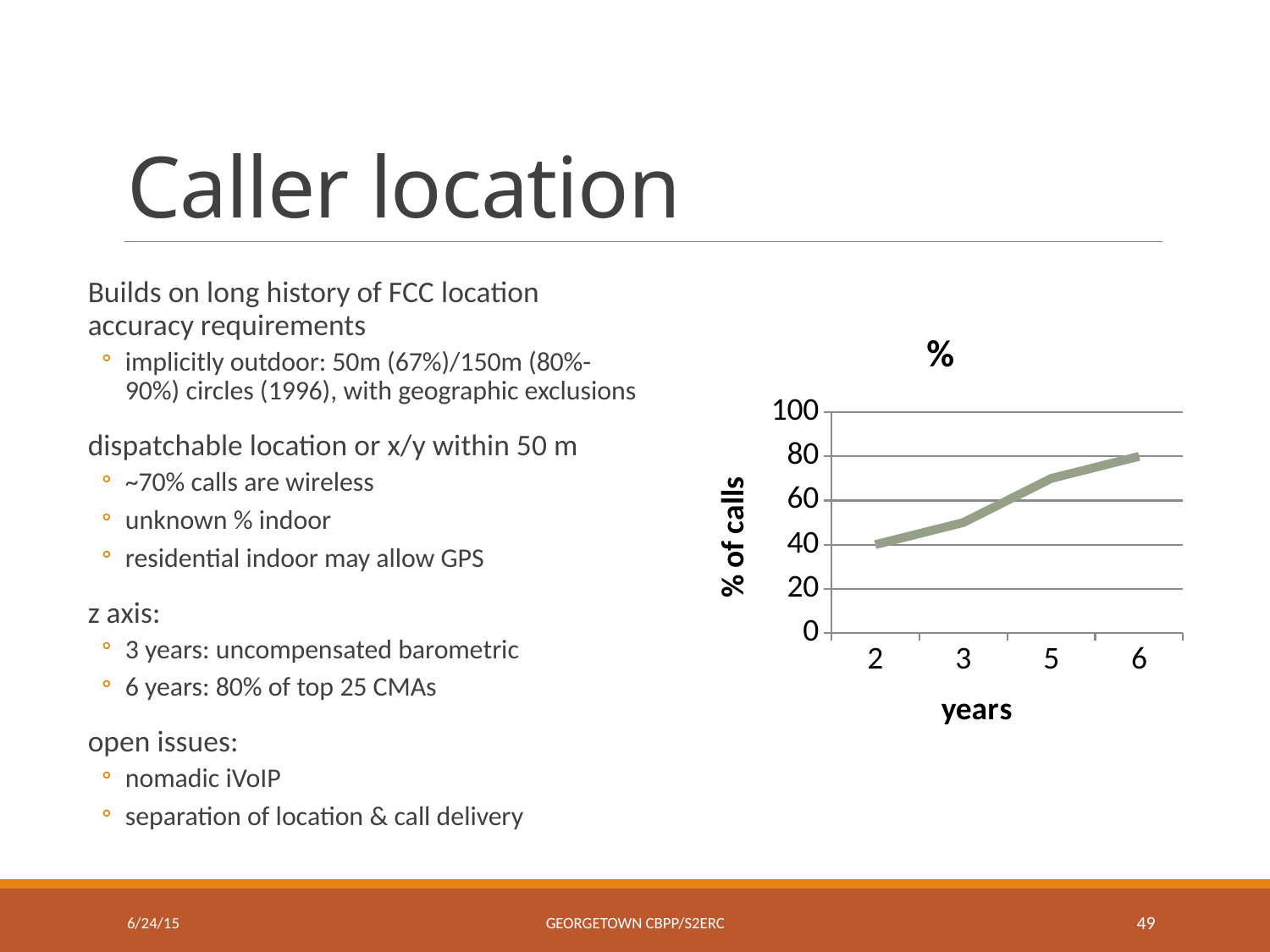
Which year has the highest % of calls? 6 What is the % of calls at year 2? 40 What is the title of the chart? % How many data points are plotted on the line? 4 Which is larger, the value for year 3 or the value for year 5? year 5 Is the value for year 5 greater or less than 60? greater What is the label of the x axis of the chart? years What is the % of calls at year 6? 80 Is the value for year 3 greater or less than 60? less What kind of chart is shown on the slide? line chart Do the values rise or fall as the years increase along the x axis? rise Which year has the lowest % of calls? 2